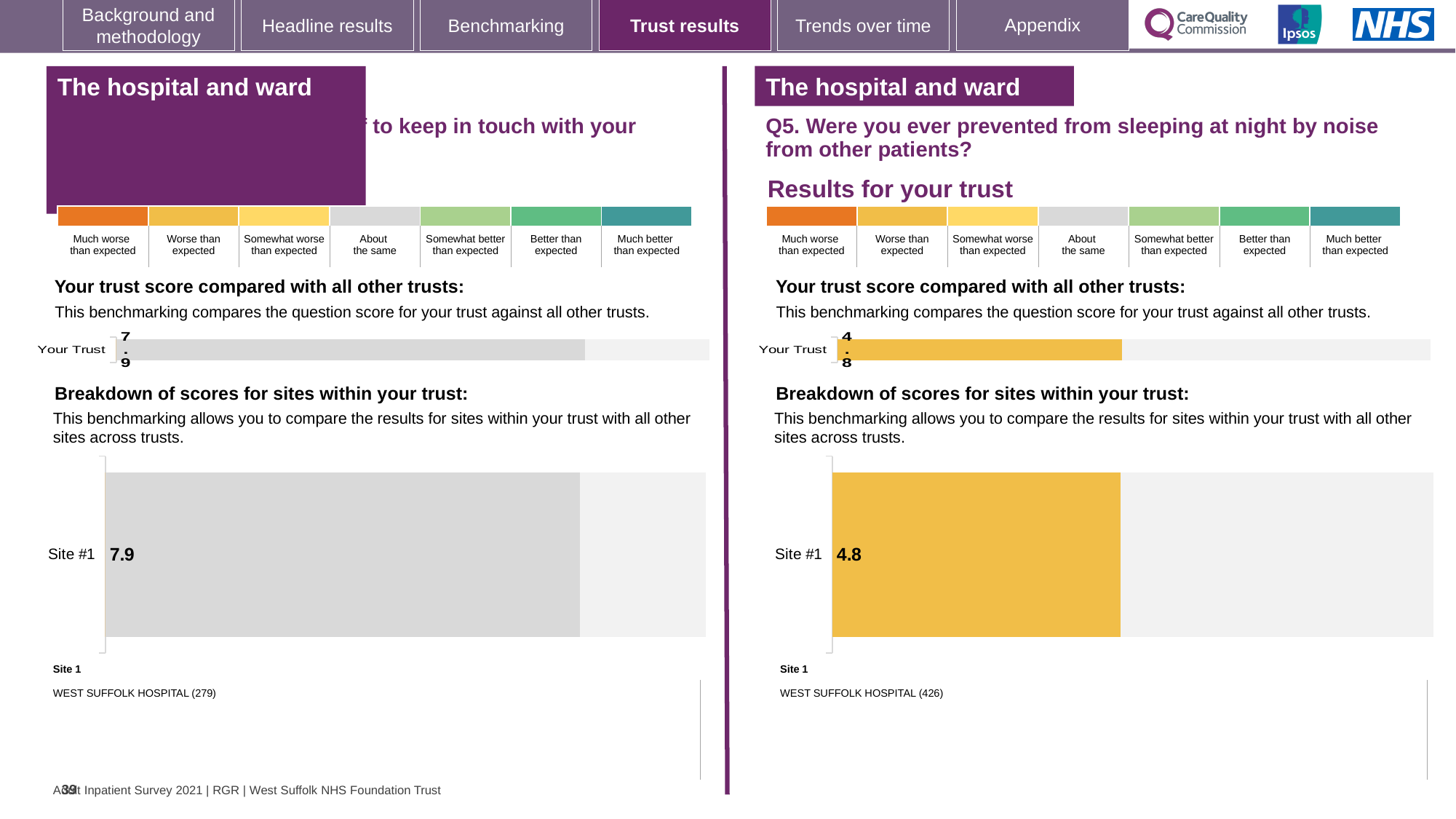
How many sites are shown in the site breakdown chart on the right half of the slide (Q5)? 1 On the right half of the slide (Q5, noise from other patients), what is the 'Your Trust' score shown in the trust comparison bar chart? 4.8 Which is larger: the Site #1 score in the left-hand site breakdown chart or the Site #1 score in the right-hand (Q5) site breakdown chart? The left-hand chart (7.9) On the left half of the slide, what is the 'Your Trust' score shown in the trust comparison bar chart? 7.9 In the site breakdown chart on the right half of the slide (Q5), what score is shown for Site #1? 4.8 How many sites are shown in the site breakdown chart on the left half of the slide? 1 In the site breakdown chart on the left half of the slide, what score is shown for Site #1? 7.9 What type of chart is used to show the Site #1 score on the right half of the slide (Q5)? Bar chart Which site name is listed as Site 1 beneath the site breakdown chart on the right half of the slide (Q5)? WEST SUFFOLK HOSPITAL (426) Which benchmarking category colour does the Site #1 bar on the right half of the slide (Q5) match in the key? Worse than expected What is the difference between the Site #1 score on the left half of the slide and the Site #1 score on the right half (Q5)? 3.1